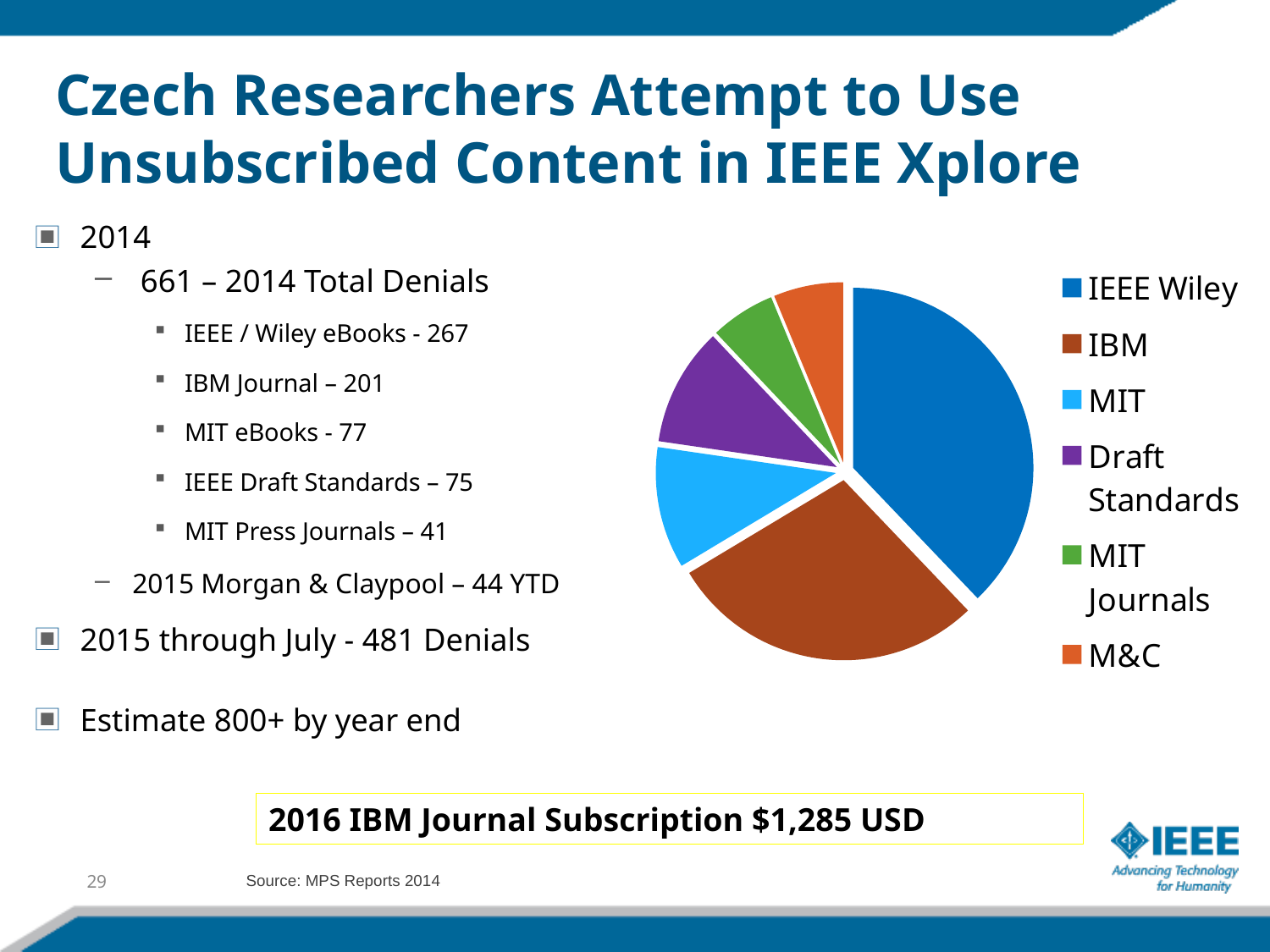
Which slice is larger in the pie chart, IEEE Wiley or IBM? IEEE Wiley How many entries does the pie chart's legend list? 6 According to the slide text, how many 2014 denials does the IBM slice represent? 201 Which slice is larger in the pie chart, IBM or MIT? IBM Using the values listed on the slide, what is the difference between the IEEE Wiley and IBM denials? 66 Which slice is larger in the pie chart, Draft Standards or MIT Journals? Draft Standards Which category has the largest slice in the pie chart? IEEE Wiley Where is the legend positioned relative to the pie chart? to the right How many slices does the pie chart have? 6 According to the slide text, how many 2014 denials does the IEEE Wiley slice represent? 267 What kind of chart is shown on the slide? pie chart What colour is the IEEE Wiley slice in the pie chart? blue